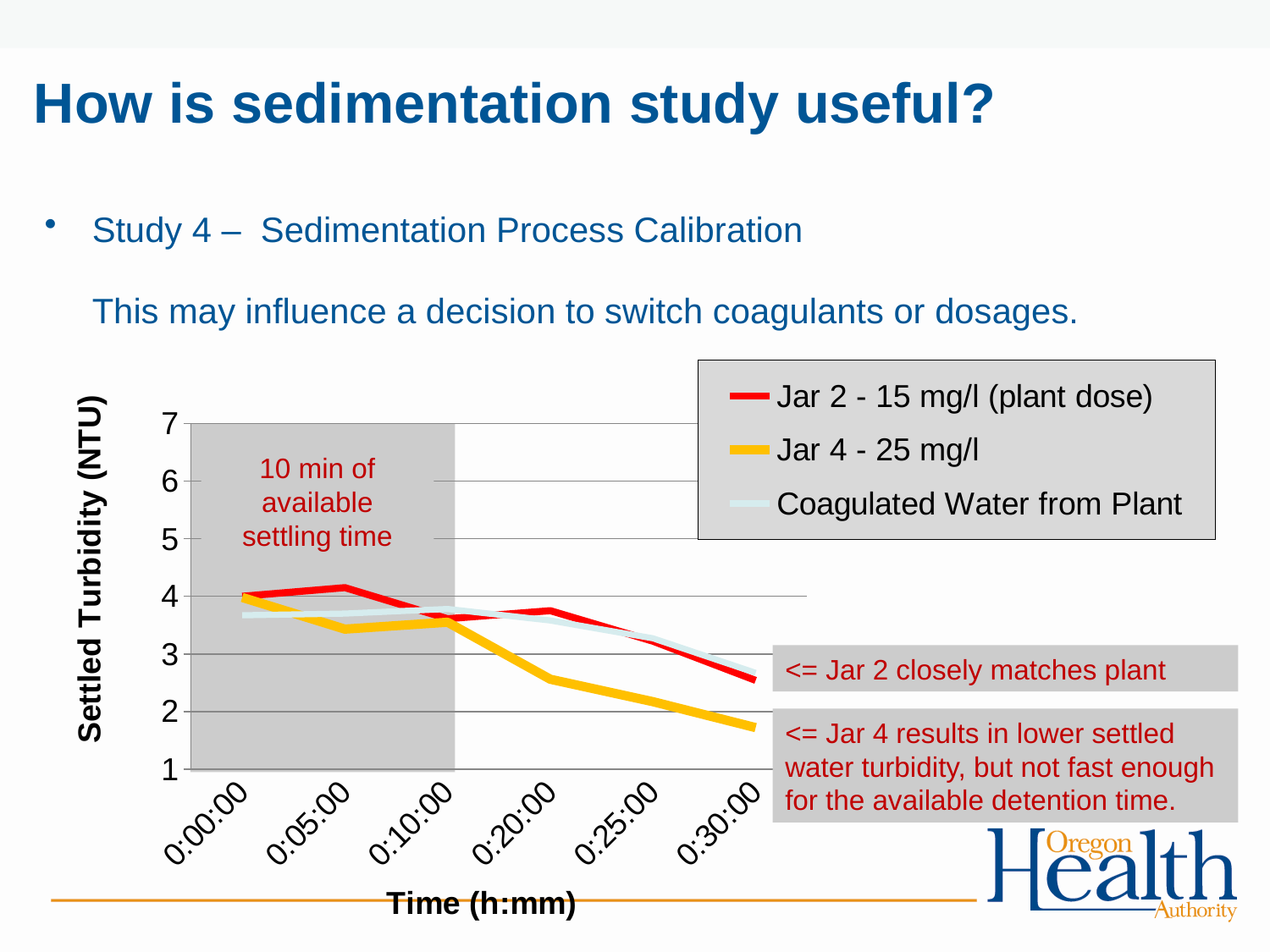
Is the value for Jar 4 - 25 mg/l at 0:20:00 greater or less than 3? less What kind of chart is shown on the slide? Line chart Is the value for Jar 2 - 15 mg/l (plant dose) at 0:05:00 greater or less than 4? greater How many time points are shown on the x axis? 6 At 0:30:00, which series has the higher settled turbidity: Jar 2 - 15 mg/l (plant dose) or Jar 4 - 25 mg/l? Jar 2 - 15 mg/l (plant dose) How many series does the legend list? 3 Is the value for Jar 4 - 25 mg/l at 0:30:00 greater or less than 2? less Does the settled turbidity for Jar 4 - 25 mg/l rise or fall from 0:05:00 to 0:30:00? Fall What does the shaded region on the left of the chart represent? 10 min of available settling time Which series has the lowest settled turbidity at 0:30:00? Jar 4 - 25 mg/l What is the label on the y axis of the chart? Settled Turbidity (NTU)